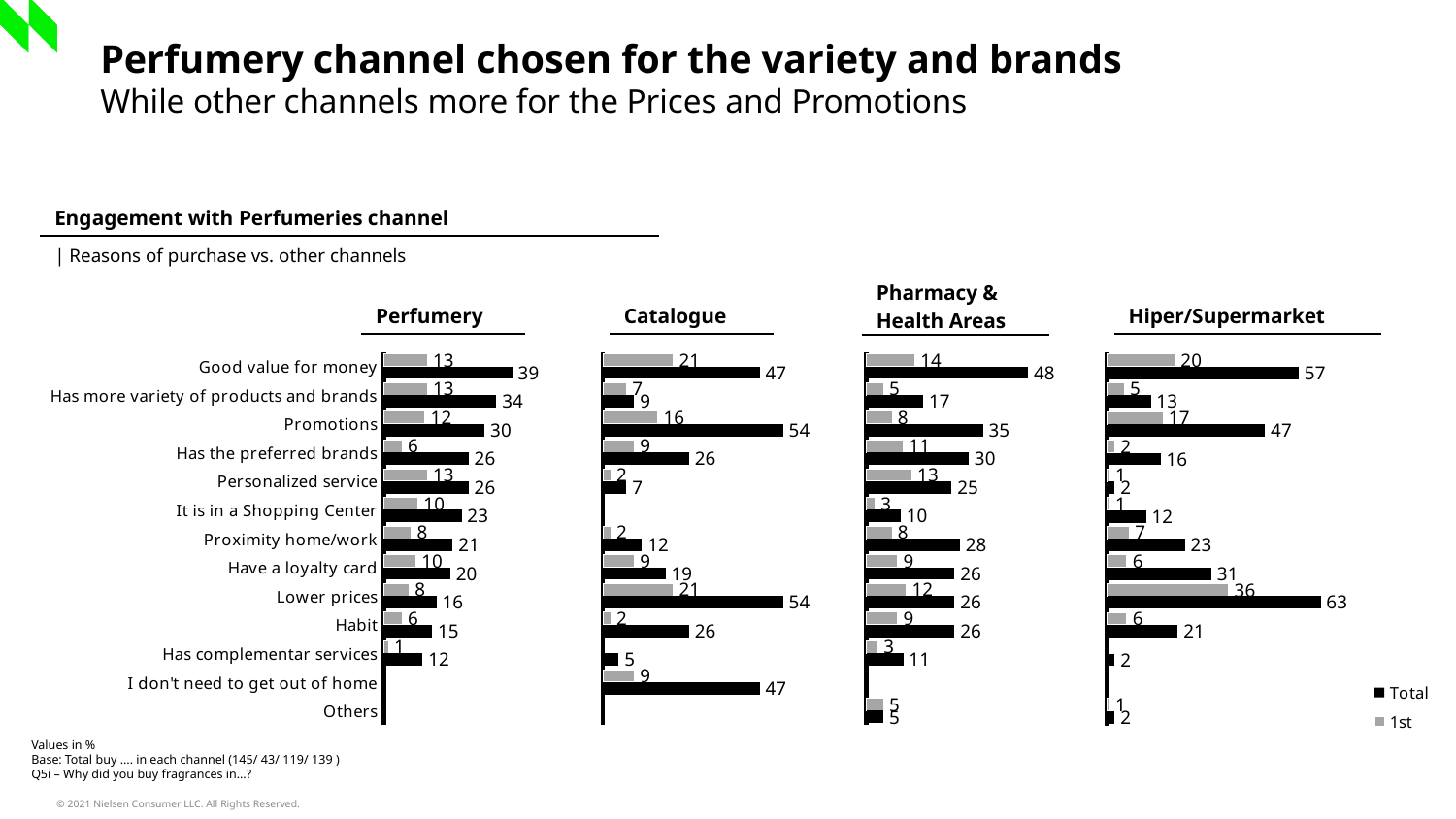
In the Hiper/Supermarket chart, what is the difference between the Total and 1st values for Promotions? 30 What type of chart is used for the Perfumery data? Bar chart In the Catalogue chart, what is the 1st value for Good value for money? 21 In the Perfumery chart, which reason has the highest Total value? Good value for money In the Pharmacy & Health Areas chart, what is the difference between the Total values for Good value for money and Has more variety of products and brands? 31 In the Hiper/Supermarket chart, what is the Total value for Lower prices? 63 Which colour represents the Total series in the charts? Black In the Catalogue chart, which is larger: the Total value for Promotions or the Total value for Has the preferred brands? Promotions In the Hiper/Supermarket chart, which reason has the highest 1st value? Lower prices In the Perfumery chart, what is the Total value for Good value for money? 39 In the Pharmacy & Health Areas chart, what is the Total value for Promotions? 35 How many series does the legend list? 2